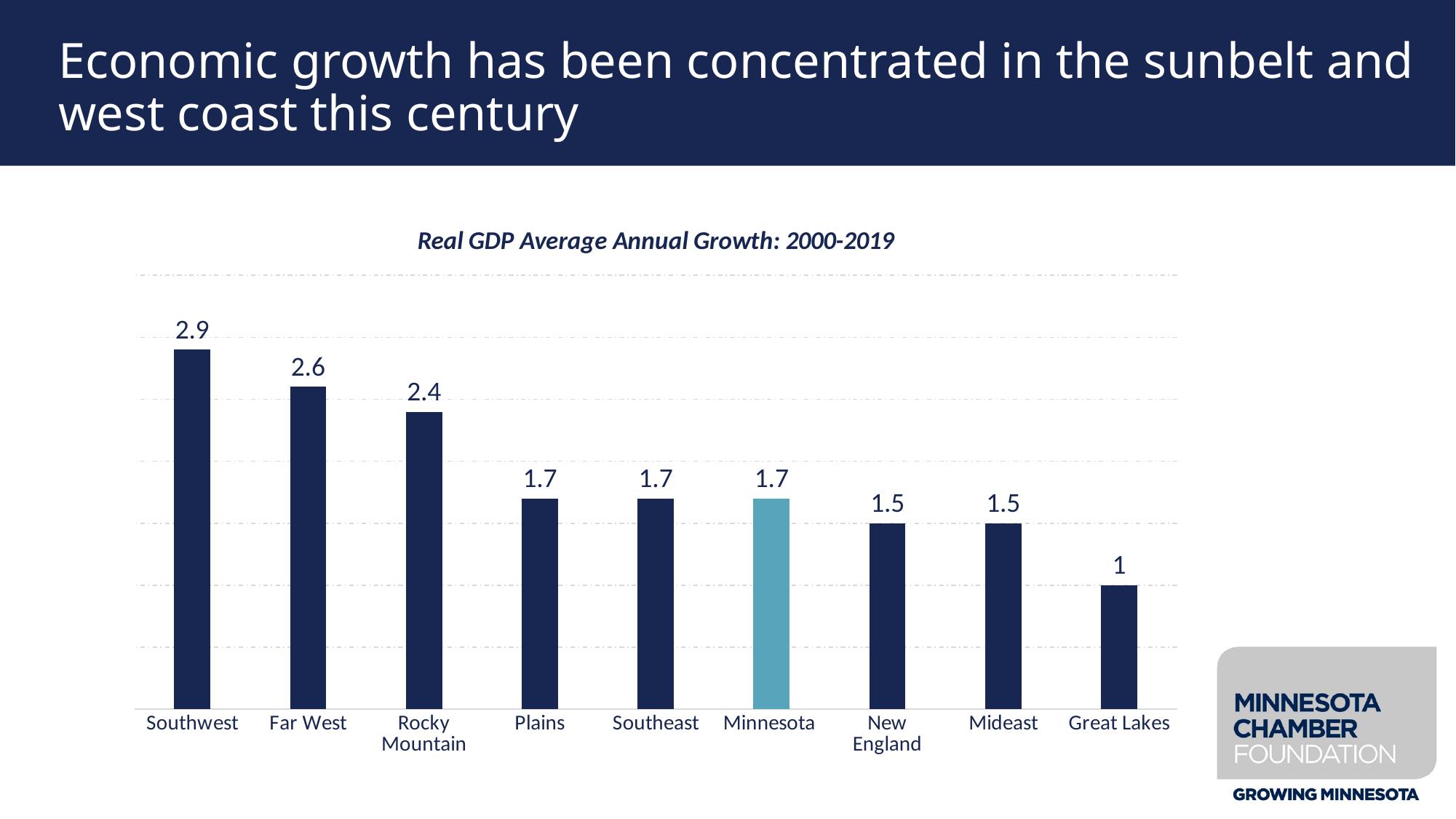
What is the value for Southwest? 2.9 What is the value for Minnesota? 1.7 Which region has the highest value? Southwest What is the difference between the values for Far West and Minnesota? 0.9 What is the difference between the values for Southwest and Great Lakes? 1.9 What is the value for Great Lakes? 1 How many regions are shown on the chart? 9 What is the value for Rocky Mountain? 2.4 Which is larger, the value for Far West or the value for Mideast? Far West Which region has the lowest value? Great Lakes What kind of chart is shown? Bar chart What is the title of the chart? Real GDP Average Annual Growth: 2000-2019